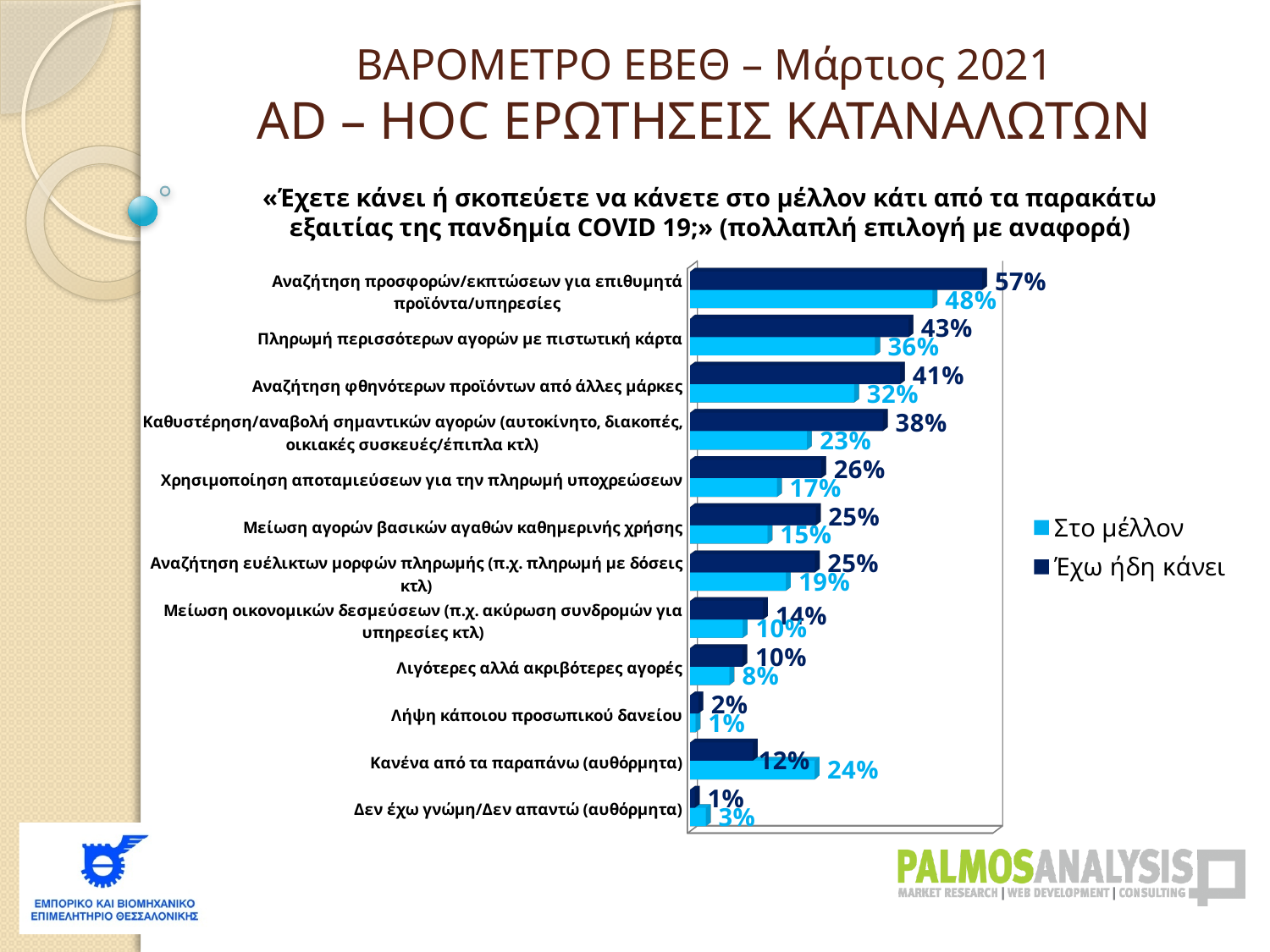
Which category has the lowest value for 'Στο μέλλον'? Λήψη κάποιου προσωπικού δανείου What is the value of 'Έχω ήδη κάνει' for 'Δεν έχω γνώμη/Δεν απαντώ (αυθόρμητα)'? 1% How many categories are shown in the chart? 12 What is the value of 'Στο μέλλον' for 'Κανένα από τα παραπάνω (αυθόρμητα)'? 24% Which series is shown in light blue in the legend? Στο μέλλον What is the difference between 'Έχω ήδη κάνει' and 'Στο μέλλον' for 'Καθυστέρηση/αναβολή σημαντικών αγορών (αυτοκίνητο, διακοπές, οικιακές συσκευές/έπιπλα κτλ)'? 15% For 'Κανένα από τα παραπάνω (αυθόρμητα)', which series has the larger value, 'Στο μέλλον' or 'Έχω ήδη κάνει'? Στο μέλλον What is the value of 'Έχω ήδη κάνει' for 'Αναζήτηση προσφορών/εκπτώσεων για επιθυμητά προϊόντα/υπηρεσίες'? 57% How many series does the legend list? 2 Which category has the highest value for 'Έχω ήδη κάνει'? Αναζήτηση προσφορών/εκπτώσεων για επιθυμητά προϊόντα/υπηρεσίες What type of chart is shown on the slide? bar chart What is the value of 'Στο μέλλον' for 'Πληρωμή περισσότερων αγορών με πιστωτική κάρτα'? 36%